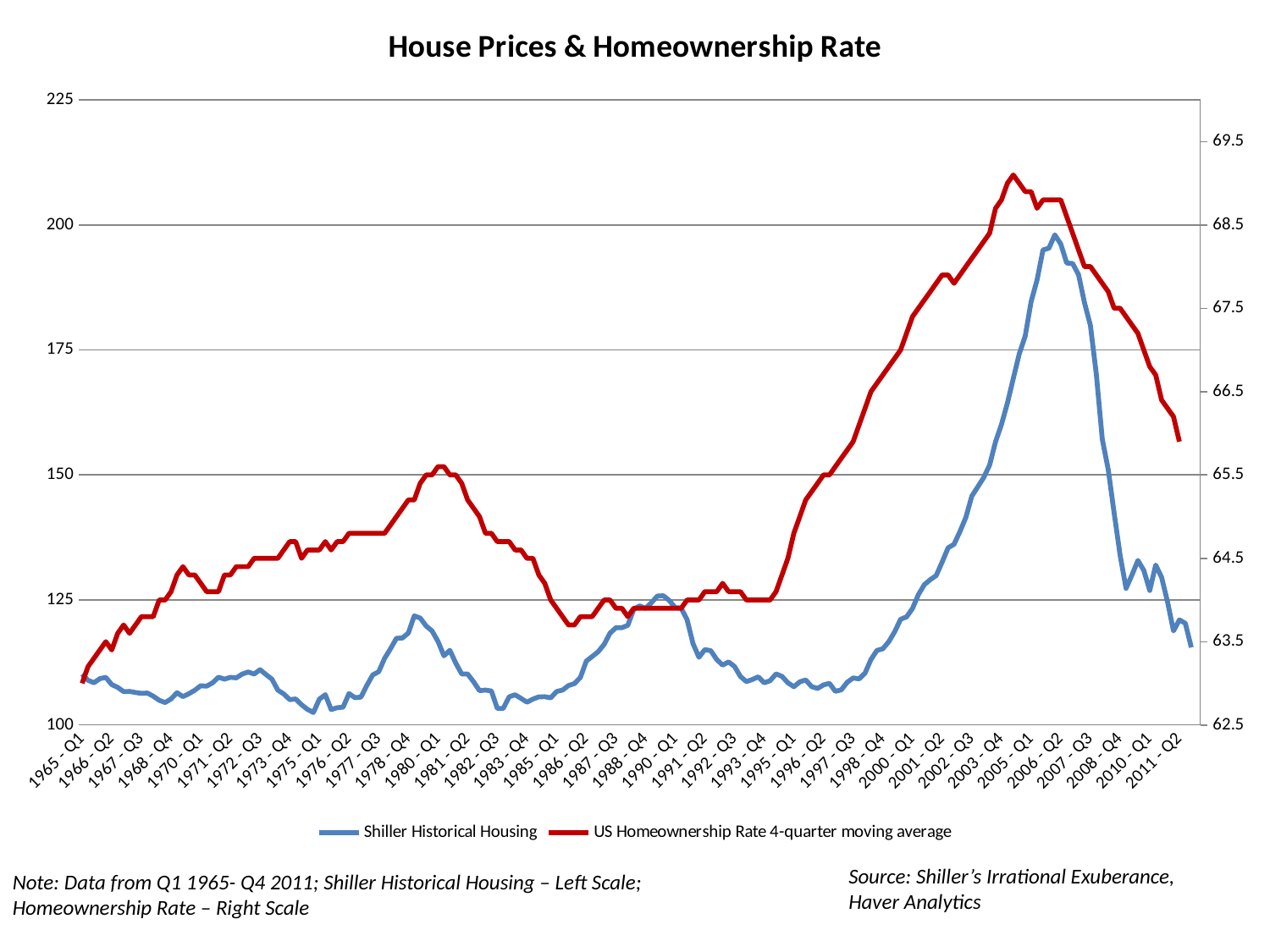
Is the value for US Homeownership Rate 4-quarter moving average at 2005 - Q1 greater or less than 68.5? greater How many series does the legend list? 2 Which series is drawn in red? US Homeownership Rate 4-quarter moving average Which is larger for US Homeownership Rate 4-quarter moving average: the value at 1965 - Q1 or the value at 2005 - Q1? 2005 - Q1 Is the value for Shiller Historical Housing at 2006 - Q2 greater or less than 175? greater Does the Shiller Historical Housing series rise or fall between 2006 - Q2 and 2011 - Q2? fall Which is larger for Shiller Historical Housing: the value at 1965 - Q1 or the value at 2006 - Q2? 2006 - Q2 What kind of chart is shown on the slide? Line chart Is the value for US Homeownership Rate 4-quarter moving average at 2011 - Q2 greater or less than 66.5? less What is the title of the chart? House Prices & Homeownership Rate Does the US Homeownership Rate 4-quarter moving average rise or fall between 1995 - Q1 and 2005 - Q1? rise